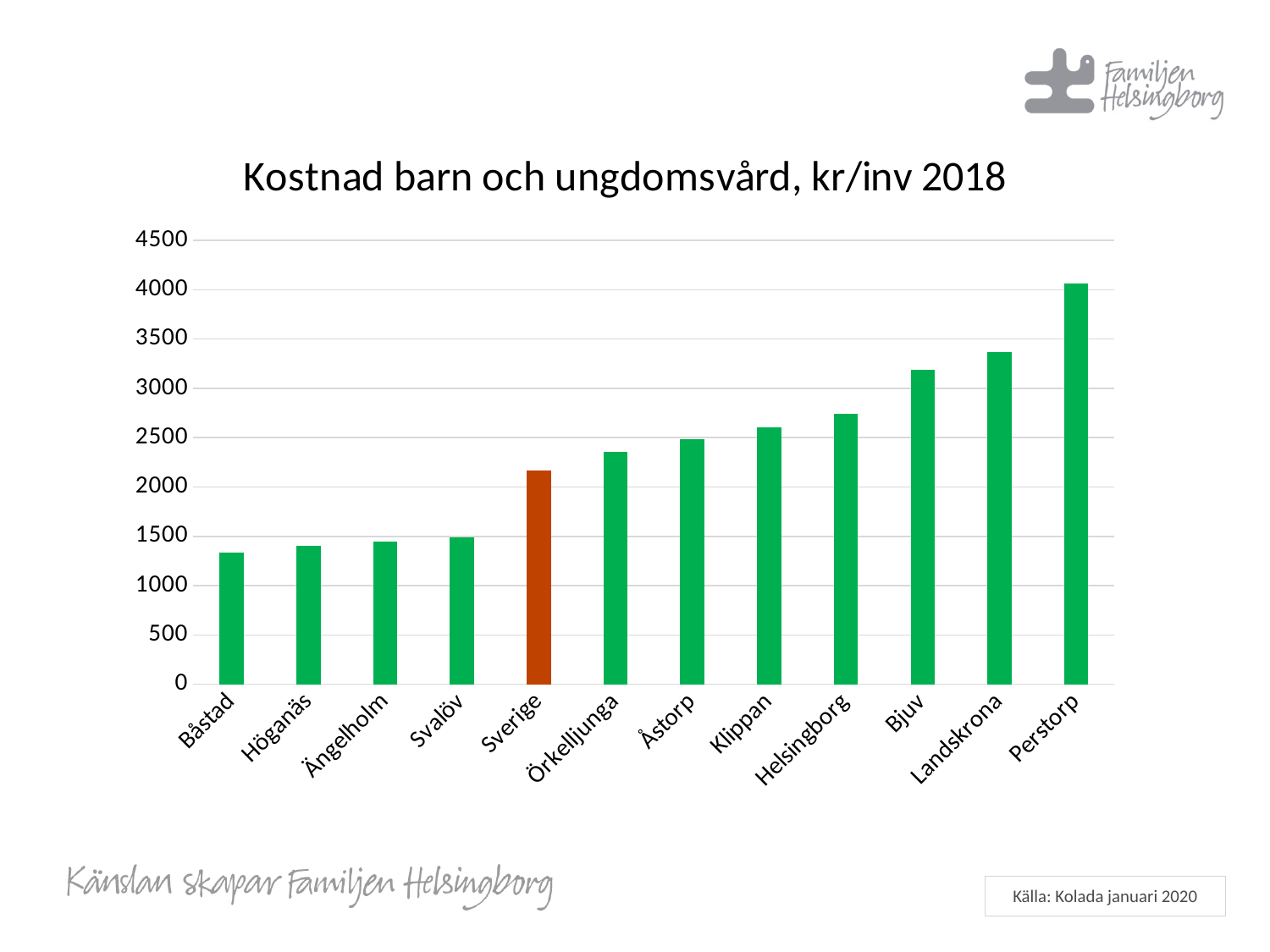
What kind of chart is shown on the slide? bar chart Which has a larger value, Landskrona or Perstorp? Perstorp Is the value for Landskrona greater or less than 3500? less Which category has the lowest value in the chart? Båstad Which bar in the chart is coloured differently (orange) from the others? Sverige How many categories are shown on the x axis of the chart? 12 Is the value for Båstad greater or less than 1500? less Do the values rise or fall from left to right along the x axis? rise Which category has the highest value in the chart? Perstorp Is the value for Bjuv greater or less than 3000? greater